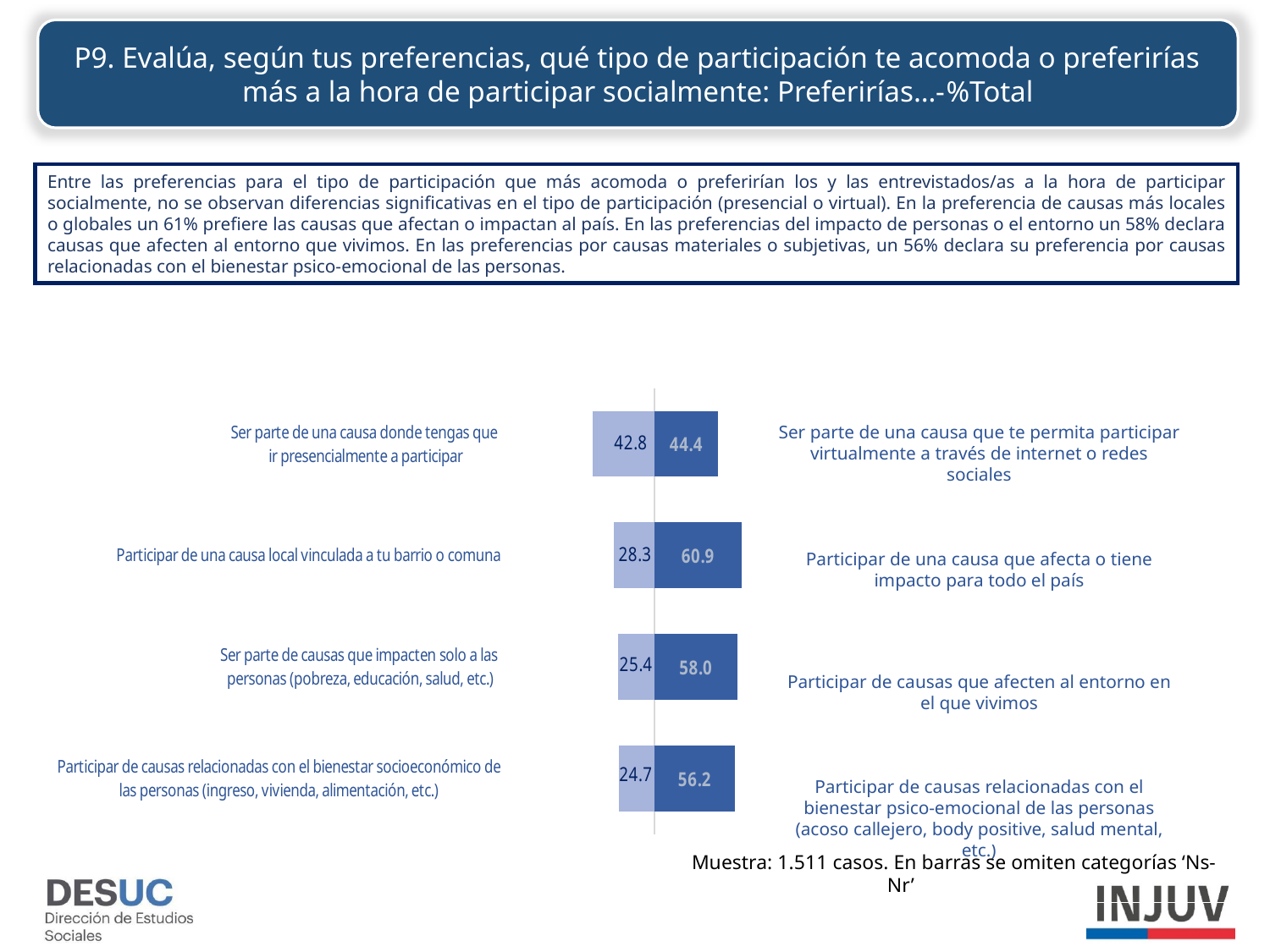
Which is larger: the value for participating presencially (ir presencialmente) or participating virtually (a través de internet o redes sociales)? Participating virtually (44.4) What type of chart is shown on the slide? Bar chart How many pairs of options are plotted in the chart? 4 What is the sample size stated below the chart? 1.511 casos What percentage prefers 'Participar de causas relacionadas con el bienestar psico-emocional de las personas'? 56.2 What percentage prefers 'Participar de una causa que afecta o tiene impacto para todo el país'? 60.9 What percentage prefers 'Ser parte de una causa donde tengas que ir presencialmente a participar'? 42.8 What is the difference between the value for 'Participar de una causa que afecta o tiene impacto para todo el país' and 'Participar de una causa local vinculada a tu barrio o comuna'? 32.6 What percentage prefers 'Participar de causas que afecten al entorno en el que vivimos'? 58.0 What percentage prefers 'Participar de una causa local vinculada a tu barrio o comuna'? 28.3 Which option on the left side of the chart has the lowest value? Participar de causas relacionadas con el bienestar socioeconómico de las personas Which option on the right side of the chart has the highest value? Participar de una causa que afecta o tiene impacto para todo el país